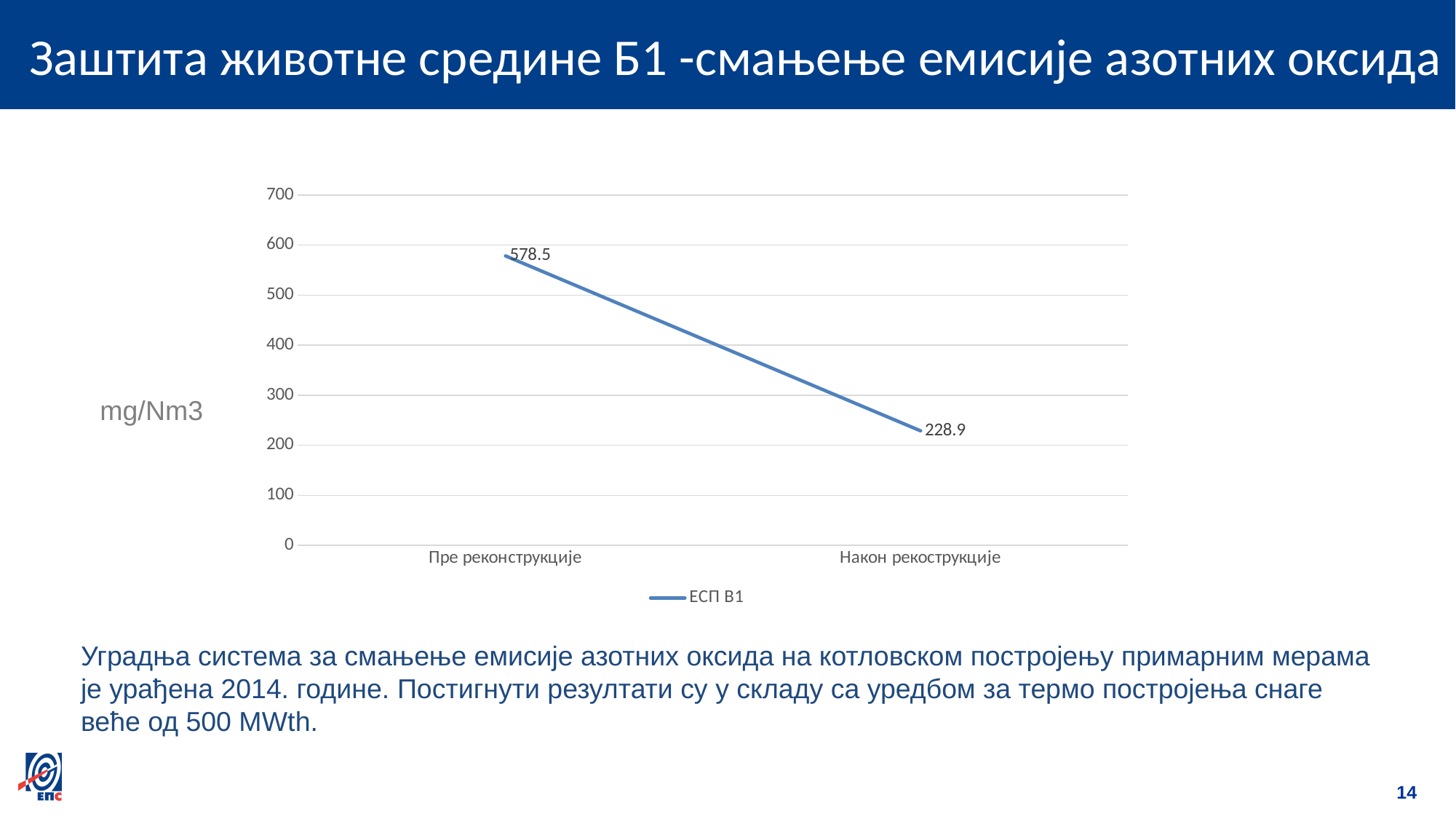
Which category has the lowest value? Након рекострукције Do the values rise or fall from "Пре реконструкције" to "Након рекострукције"? fall What is the difference between the value before reconstruction (Пре реконструкције) and after reconstruction (Након рекострукције)? 349.6 Is the value for "Пре реконструкције" greater or less than 500? greater Which category has the highest value? Пре реконструкције What kind of chart is shown on the slide? line chart What is the value for "Пре реконструкције"? 578.5 How many categories are shown on the x axis? 2 What is the value for "Након рекострукције"? 228.9 Which is larger, the value for "Пре реконструкције" or for "Након рекострукције"? Пре реконструкције Is the value for "Након рекострукције" greater or less than 300? less How many series does the legend list? 1